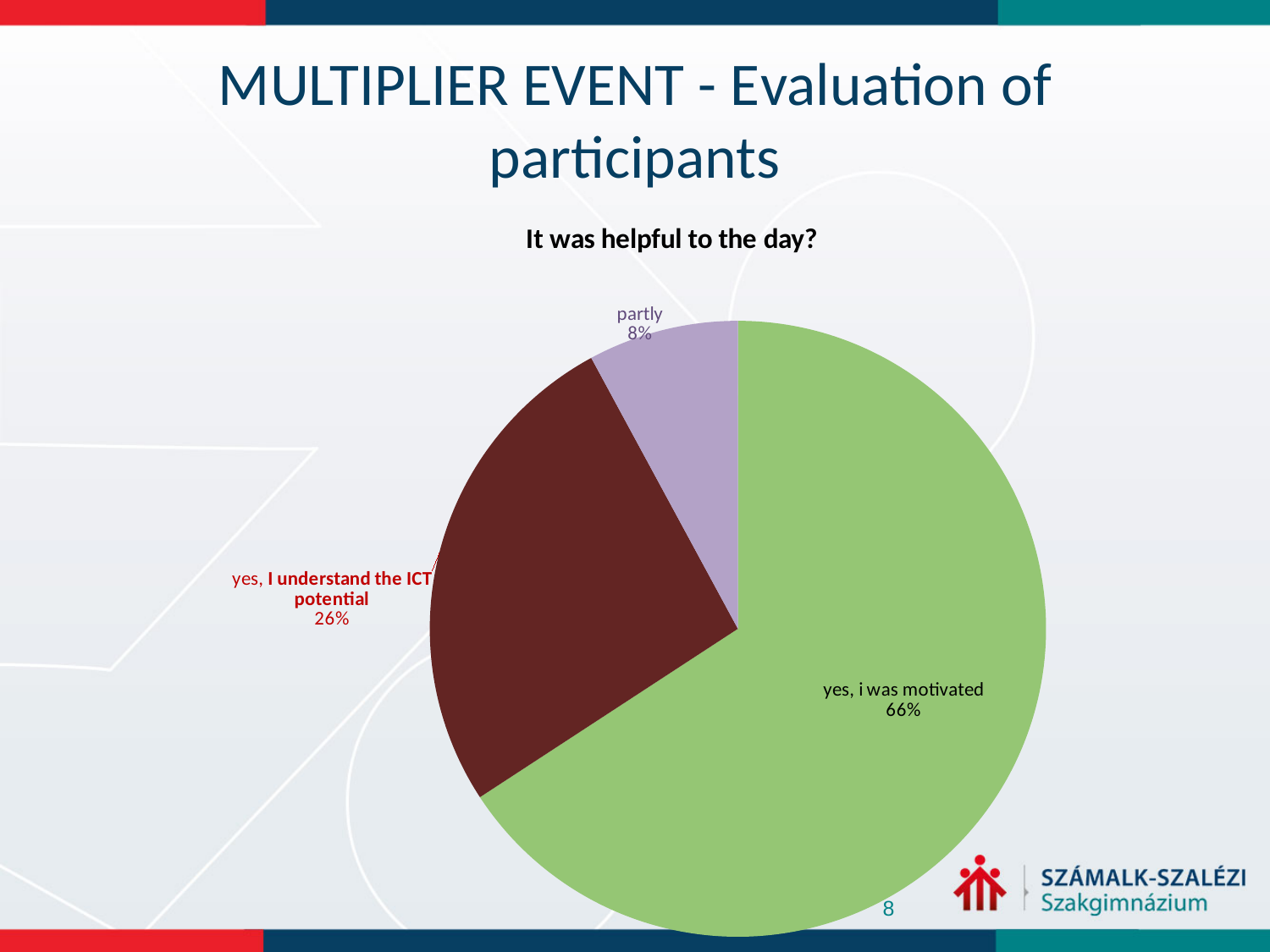
What share of the pie is labelled "partly"? 8% What is the difference in percentage points between the "yes, i was motivated" slice and the "yes, I understand the ICT potential" slice? 40 What share of the pie is labelled "yes, I understand the ICT potential"? 26% What kind of chart is shown on the slide? pie chart How many slices does the pie chart have? 3 Which slice of the pie is the smallest? partly What is the title of the chart? It was helpful to the day? What is the combined share of the two "yes" slices? 92% What colour is the "yes, i was motivated" slice? green Which slice of the pie is the largest? yes, i was motivated Which is larger: the "yes, I understand the ICT potential" slice or the "partly" slice? yes, I understand the ICT potential What share of the pie is labelled "yes, i was motivated"? 66%